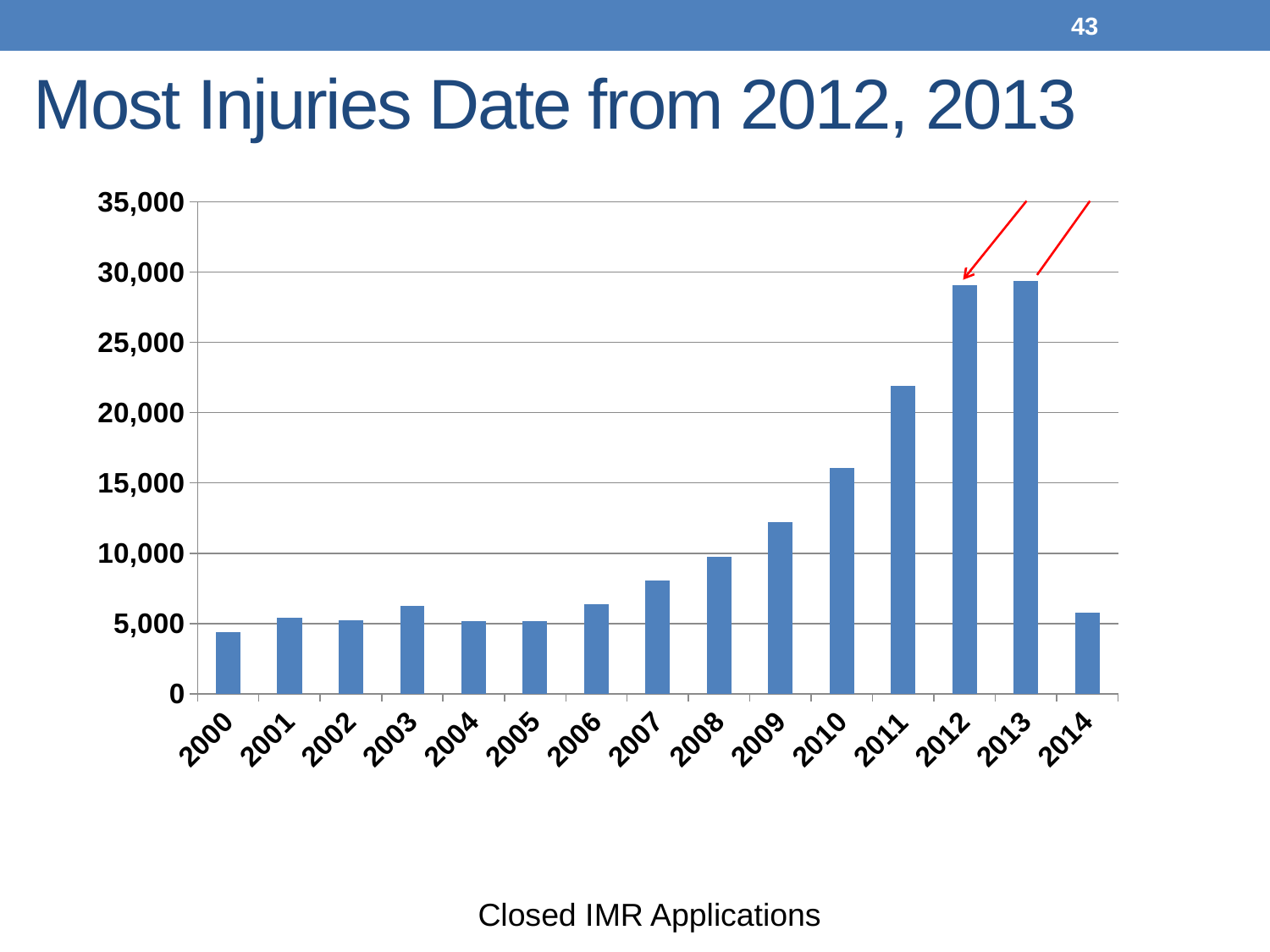
How many years are shown on the x axis of the chart? 15 Do the values generally rise or fall from 2005 to 2013? rise Is the value for 2011 greater or less than 20,000? greater Which year has the larger value, 2010 or 2011? 2011 Is the value for 2009 greater or less than 10,000? greater Which year has the lowest bar in the chart? 2000 Which year has the larger value, 2006 or 2007? 2007 Is the value for 2000 greater or less than 5,000? less What caption appears below the chart? Closed IMR Applications What kind of chart is shown on the slide? bar chart